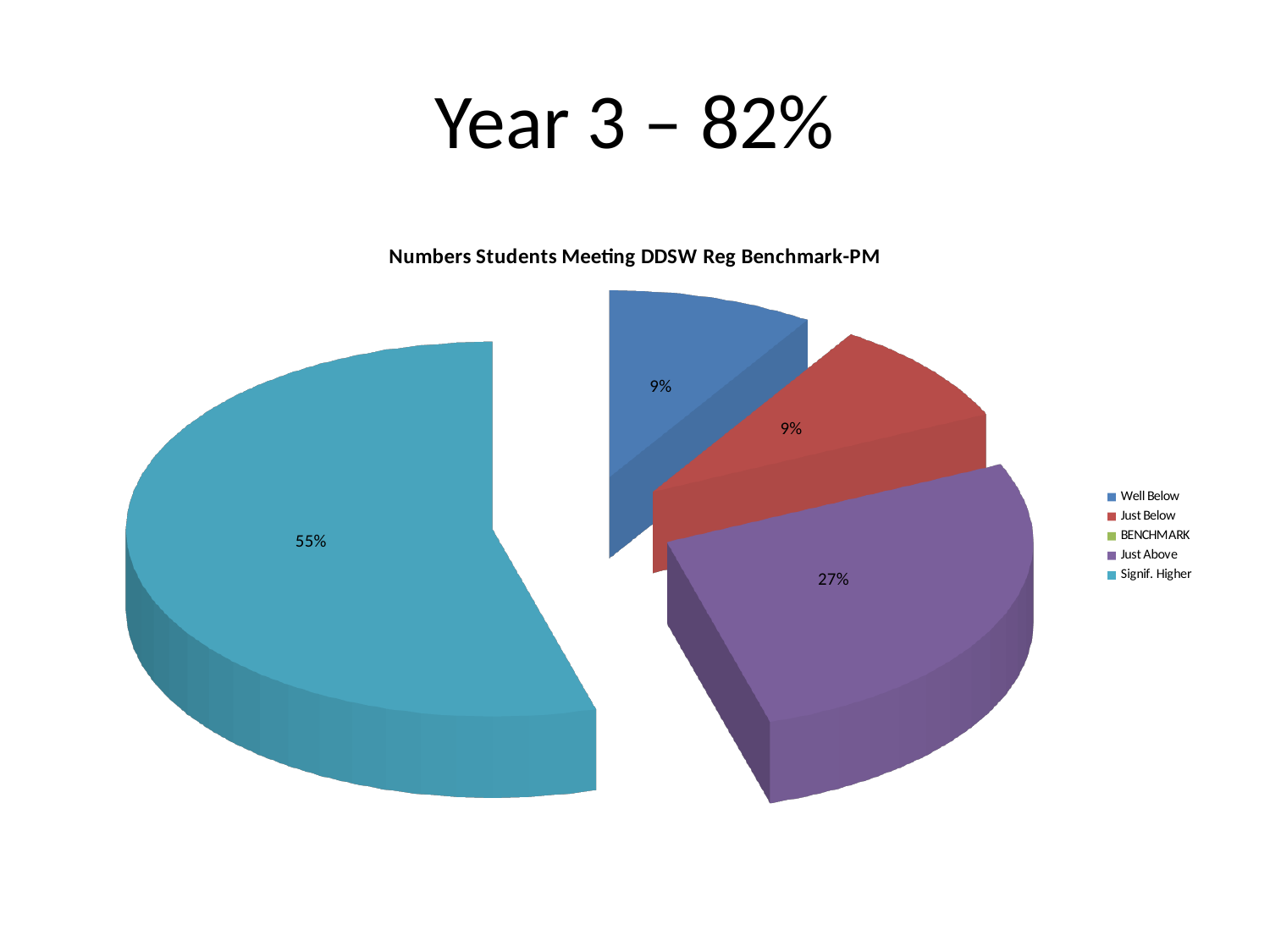
What colour is the Signif. Higher slice? teal How many categories are listed in the legend? 5 Which category has the largest slice of the pie? Signif. Higher Which is larger, the Just Above slice or the Just Below slice? Just Above What percentage of the pie is the Well Below slice? 9% What percentage of the pie is the Signif. Higher slice? 55% How many slices are visible in the pie? 4 What is the title of the chart? Numbers Students Meeting DDSW Reg Benchmark-PM What type of chart is shown on the slide? pie chart What is the difference in percentage points between the Signif. Higher slice and the Just Above slice? 28 What percentage of the pie is the Just Below slice? 9%